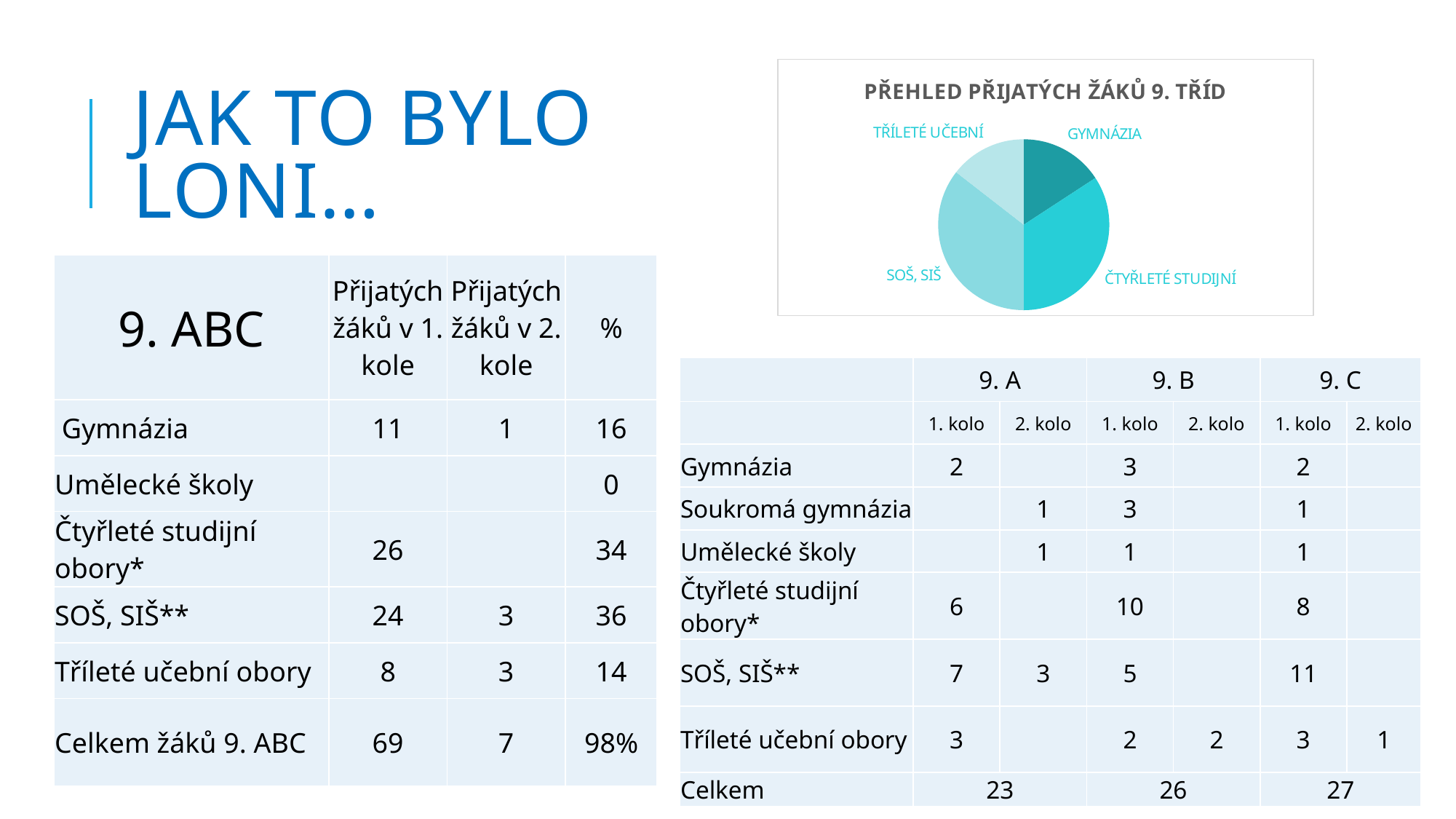
Which slice of the pie chart is larger, TŘÍLETÉ UČEBNÍ or ČTYŘLETÉ STUDIJNÍ? ČTYŘLETÉ STUDIJNÍ Which slice of the pie chart is drawn in the darkest teal colour? GYMNÁZIA Which slice of the pie chart is larger, ČTYŘLETÉ STUDIJNÍ or GYMNÁZIA? ČTYŘLETÉ STUDIJNÍ Which slice of the pie chart is larger, GYMNÁZIA or SOŠ, SIŠ? SOŠ, SIŠ How many slices does the pie chart have? 4 What kind of chart is shown on the slide? pie chart What is the title of the pie chart? PŘEHLED PŘIJATÝCH ŽÁKŮ 9. TŘÍD